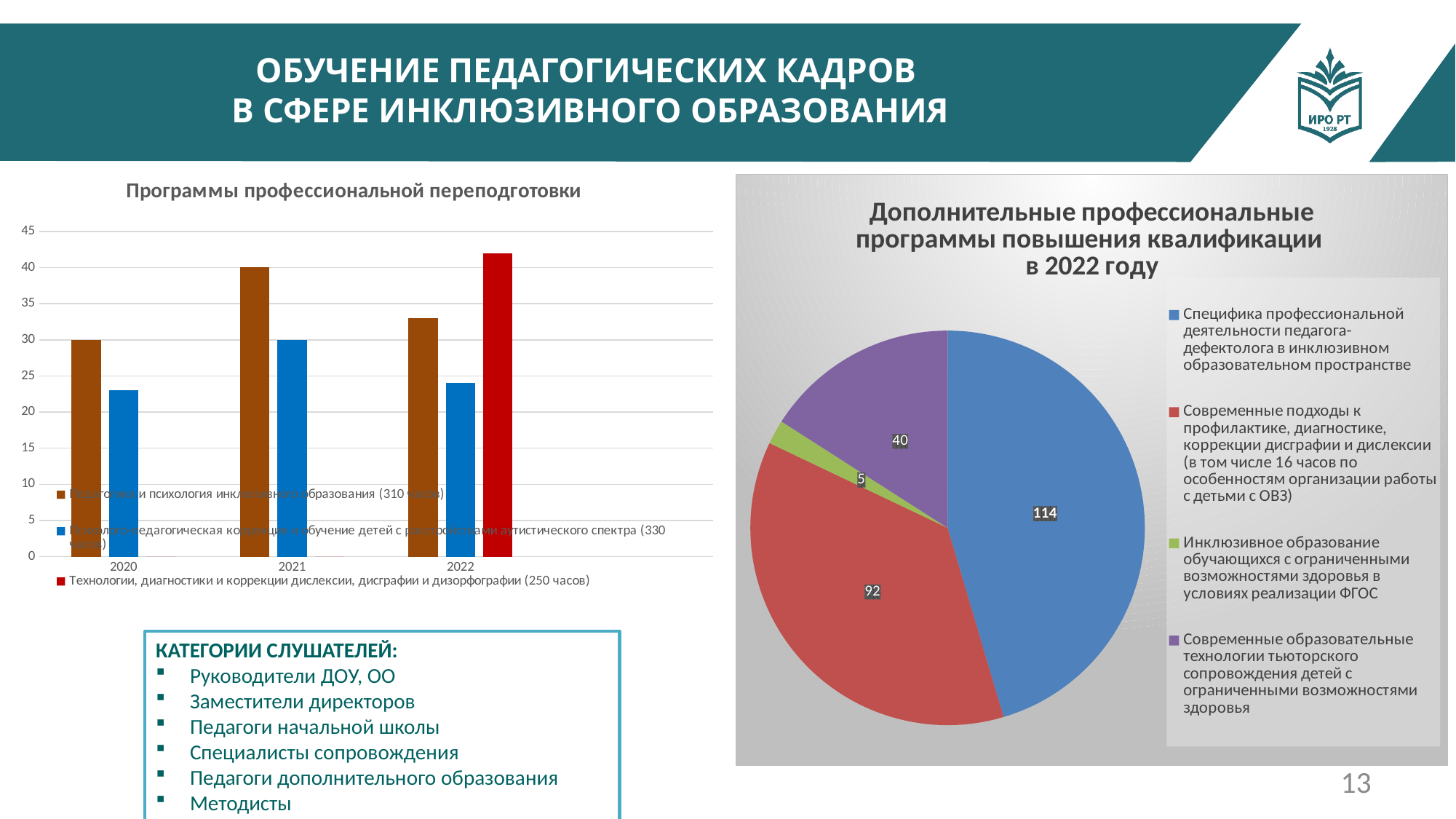
In the pie chart "Дополнительные профессиональные программы повышения квалификации в 2022 году", what is the difference between the value for "Специфика профессиональной деятельности педагога-дефектолога в инклюзивном образовательном пространстве" and the value for "Современные образовательные технологии тьюторского сопровождения детей с ограниченными возможностями здоровья"? 74 In the bar chart "Программы профессиональной переподготовки", which year has the highest value for "Педагогика и психология инклюзивного образования (310 часов)"? 2021 In the pie chart "Дополнительные профессиональные программы повышения квалификации в 2022 году", what is the value for "Инклюзивное образование обучающихся с ограниченными возможностями здоровья в условиях реализации ФГОС"? 5 In the pie chart "Дополнительные профессиональные программы повышения квалификации в 2022 году", which slice is the largest? Специфика профессиональной деятельности педагога-дефектолога в инклюзивном образовательном пространстве In the bar chart "Программы профессиональной переподготовки", what is the value for "Педагогика и психология инклюзивного образования (310 часов)" in 2021? 40 What kind of chart is the chart titled "Программы профессиональной переподготовки"? bar chart What kind of chart is the chart titled "Дополнительные профессиональные программы повышения квалификации в 2022 году"? pie chart In the bar chart "Программы профессиональной переподготовки", is the value for "Технологии, диагностики и коррекции дислексии, дисграфии и дизорфографии (250 часов)" in 2022 greater or less than 40? greater In the bar chart "Программы профессиональной переподготовки", how many years are shown on the x axis? 3 In the pie chart "Дополнительные профессиональные программы повышения квалификации в 2022 году", how many slices are there? 4 In the bar chart "Программы профессиональной переподготовки", in which year does the red series "Технологии, диагностики и коррекции дислексии, дисграфии и дизорфографии (250 часов)" appear? 2022 In the bar chart "Программы профессиональной переподготовки", how many series does the legend list? 3